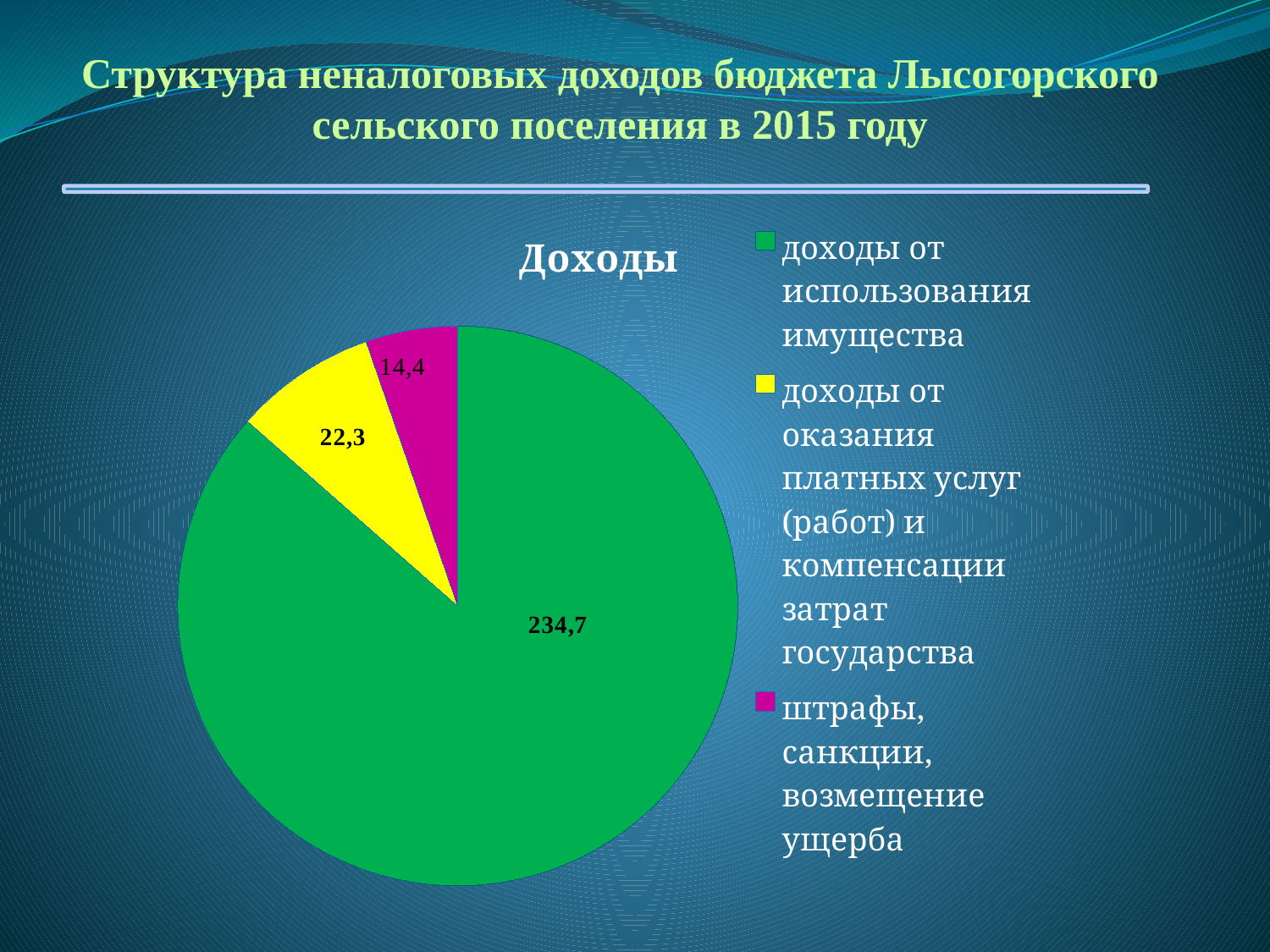
How many slices does the pie chart have? 3 Which is larger: the value for "доходы от оказания платных услуг (работ) и компенсации затрат государства" or the value for "штрафы, санкции, возмещение ущерба"? доходы от оказания платных услуг (работ) и компенсации затрат государства How many entries does the legend list? 3 What colour is the slice for "штрафы, санкции, возмещение ущерба"? magenta What is the title of the chart? Доходы What type of chart is shown on the slide? pie chart Which category has the largest slice? доходы от использования имущества Which category has the smallest slice? штрафы, санкции, возмещение ущерба What is the difference between the value for "доходы от использования имущества" and the value for "доходы от оказания платных услуг (работ) и компенсации затрат государства"? 212,4 What is the value for "доходы от использования имущества"? 234,7 What is the value for "штрафы, санкции, возмещение ущерба"? 14,4 What is the value for "доходы от оказания платных услуг (работ) и компенсации затрат государства"? 22,3